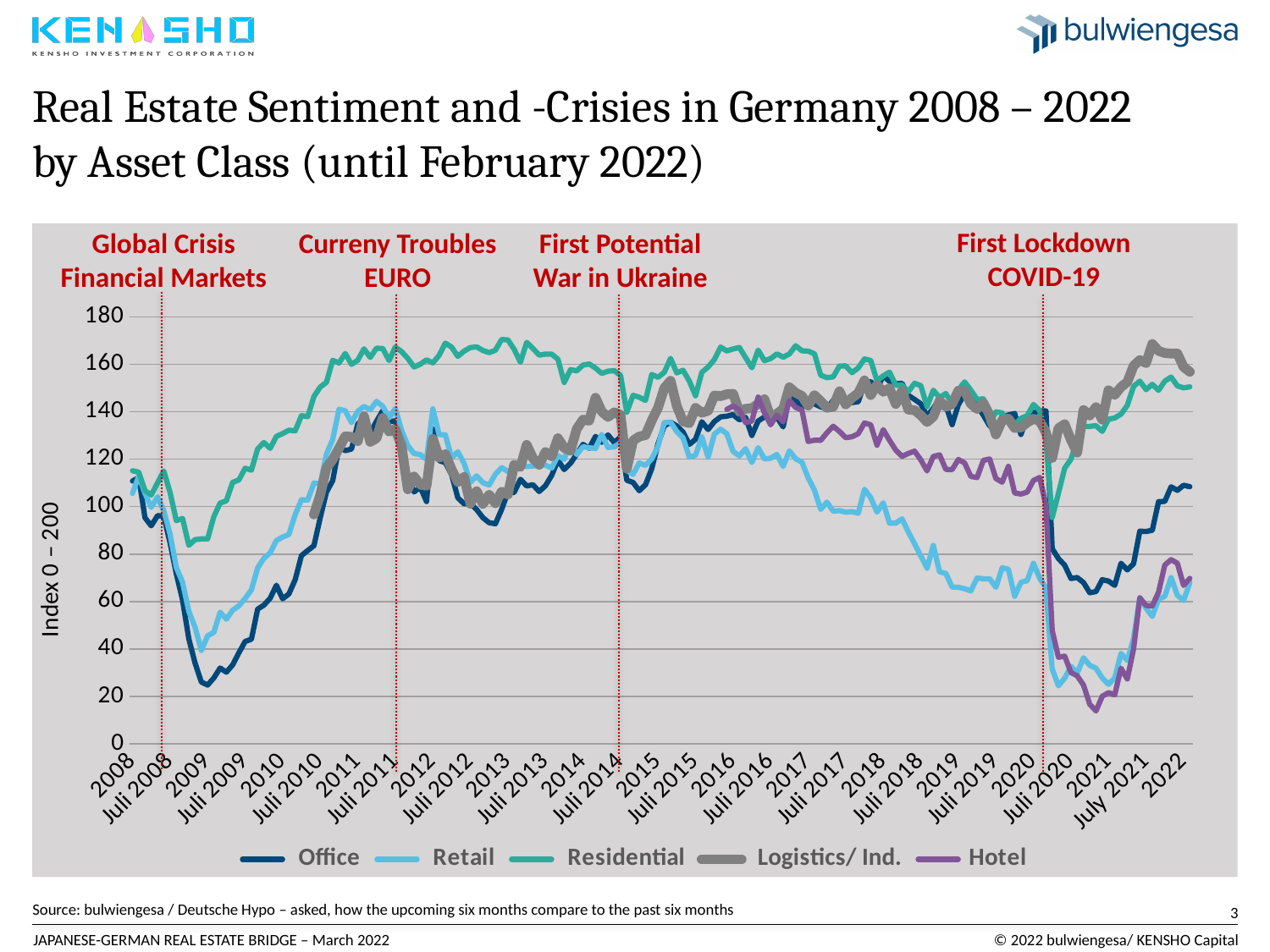
How many series does the legend list? 5 Is the value for Office at its low point in 2009 greater or less than 40? less Is the value for Residential at its peak around 2013 greater or less than 160? greater Which series has the highest value around 2013? Residential Is the value for Retail at its low point in 2009 greater or less than 60? less What is the label of the vertical axis? Index 0 – 200 Does the Retail series rise or fall between 2017 and 2019? Fall What kind of chart is shown on the slide? Line chart Which series has the lowest value in early 2021? Hotel Around Juli 2020, which is higher, Retail or Residential? Residential Which asset classes are listed in the chart legend? Office, Retail, Residential, Logistics/ Ind., Hotel